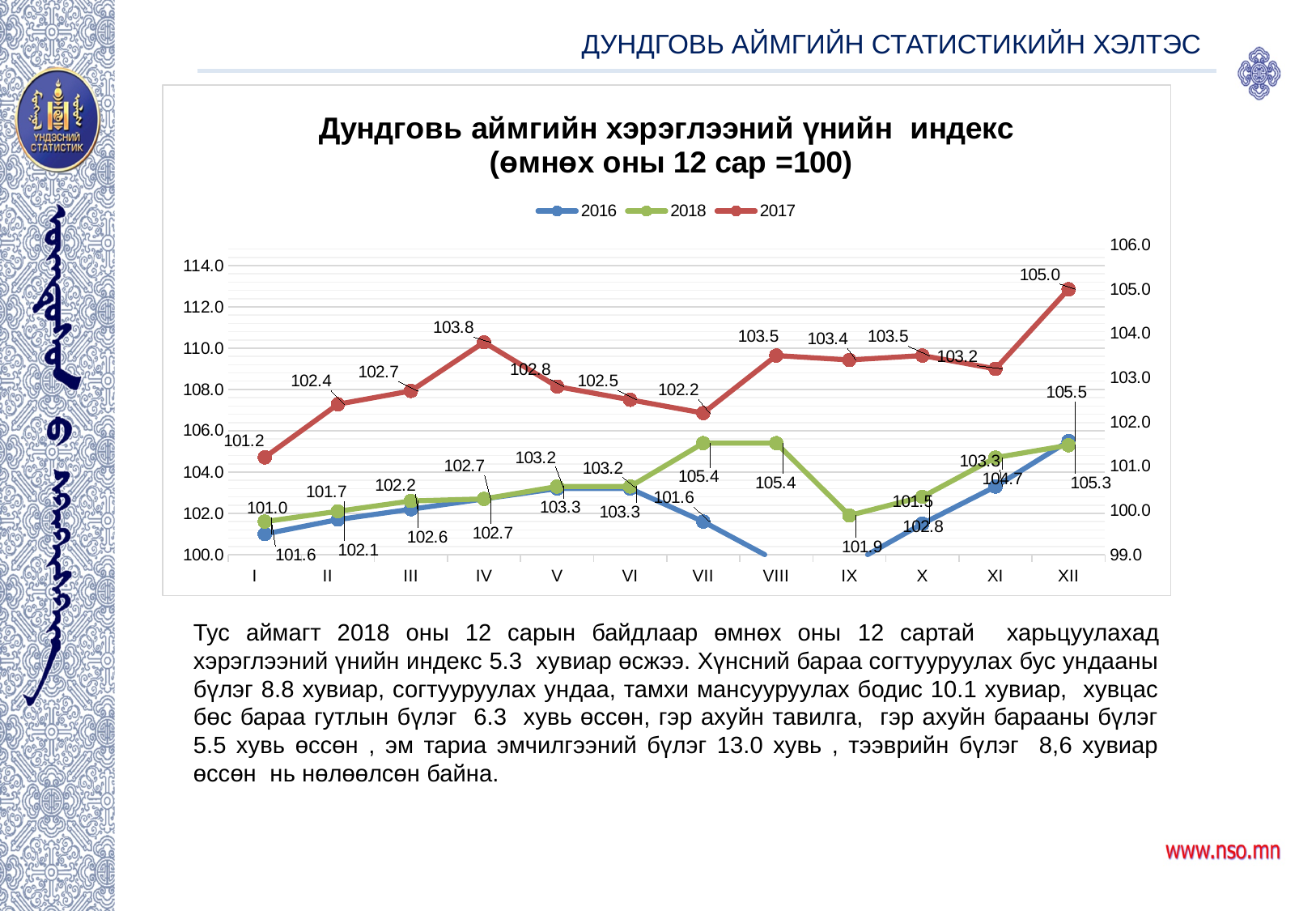
What is the value for the 2017 series in month IV? 103.8 In which month does the 2017 series reach its highest value? XII What is the value for the 2018 series in month IX? 101.9 How many series does the legend list? 3 What is the value for the 2017 series in month XII? 105.0 Does the 2017 series rise or fall from month I to month IV? rise Which is larger for the 2017 series: the value in month IV or in month V? month IV What is the difference between the 2017 values in month XII and month I? 3.8 What kind of chart is shown on the slide? line chart What is the value for the 2018 series in month XII? 105.3 In which month does the 2017 series have its lowest value? I How many months (categories) are shown on the x axis? 12